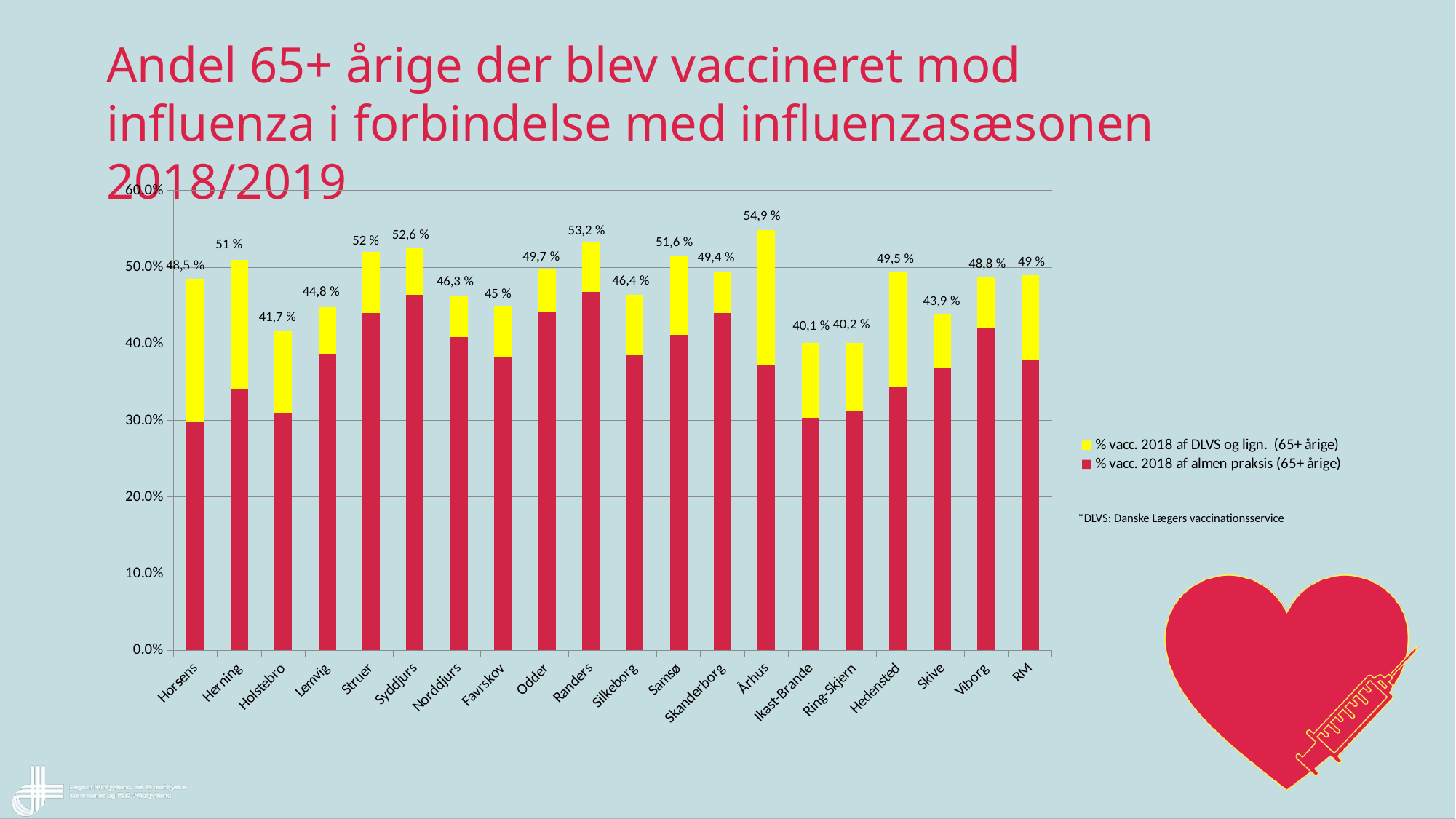
What is the total vaccination share shown for Holstebro? 41,7 % How many categories are shown on the x axis? 20 What is the total vaccination share shown for RM? 49 % Which municipality has the lowest total vaccination share? Ikast-Brande Which municipality has the highest total vaccination share? Århus Is the red segment (almen praksis) for Århus greater or less than 40.0%? less How many series does the legend list? 2 What kind of chart is shown on the slide? Stacked bar chart What is the difference between the total for Århus and the total for Ikast-Brande? 14,8 % Which has a higher total vaccination share, Randers or Horsens? Randers What is the total vaccination share shown for Århus? 54,9 % Is the red segment (almen praksis) for Viborg greater or less than 40.0%? greater